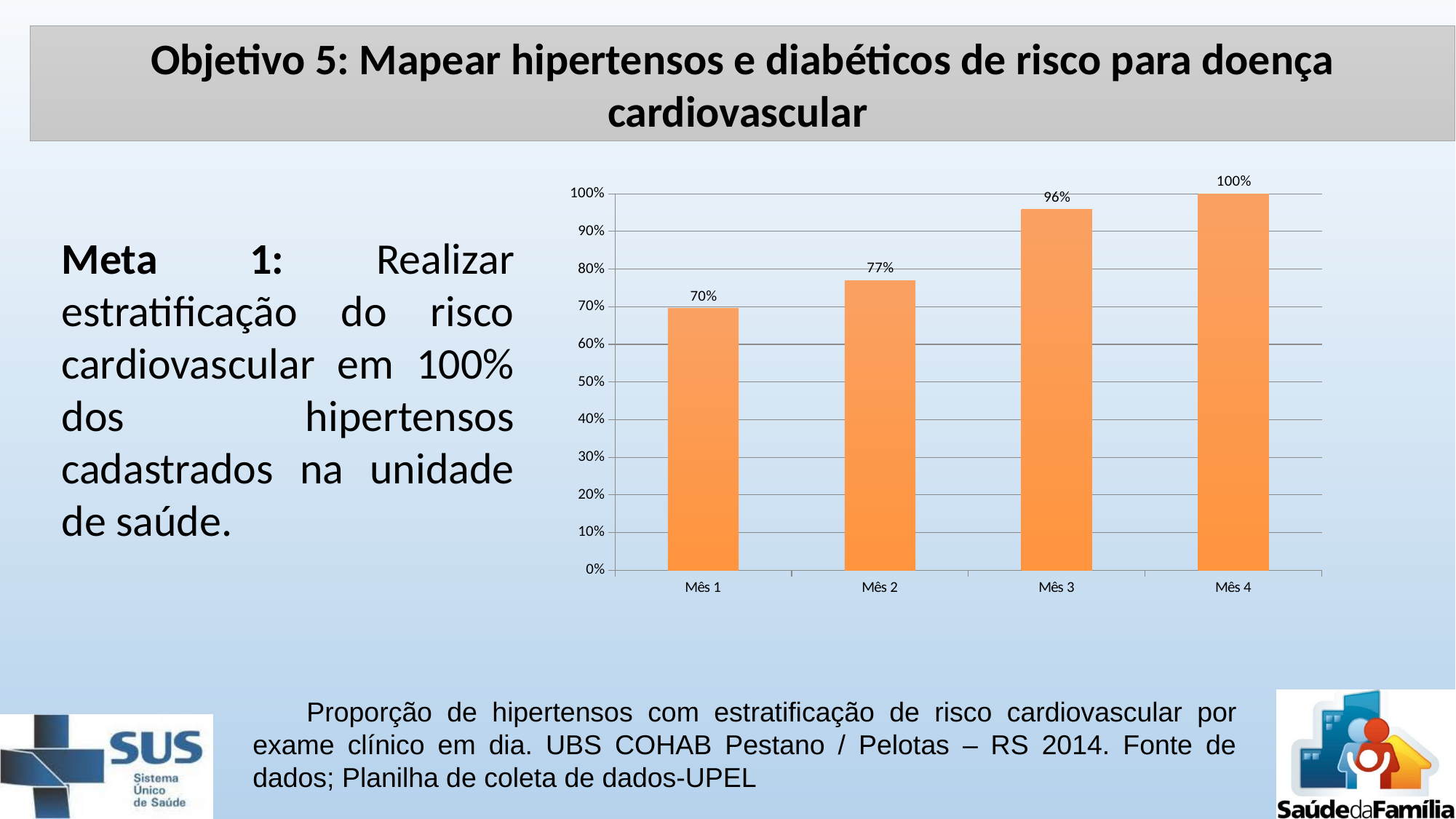
What is the difference between the values for Mês 4 and Mês 1? 30% What is the value for Mês 2? 77% What is the difference between the values for Mês 3 and Mês 2? 19% Do the values rise or fall from Mês 1 to Mês 4? Rise Which is larger, the value for Mês 2 or the value for Mês 3? Mês 3 What is the value for Mês 1? 70% How many months are shown on the x axis? 4 What is the value for Mês 4? 100% Which month has the highest value? Mês 4 What kind of chart is shown on the slide? Bar chart Which month has the lowest value? Mês 1 What is the value for Mês 3? 96%